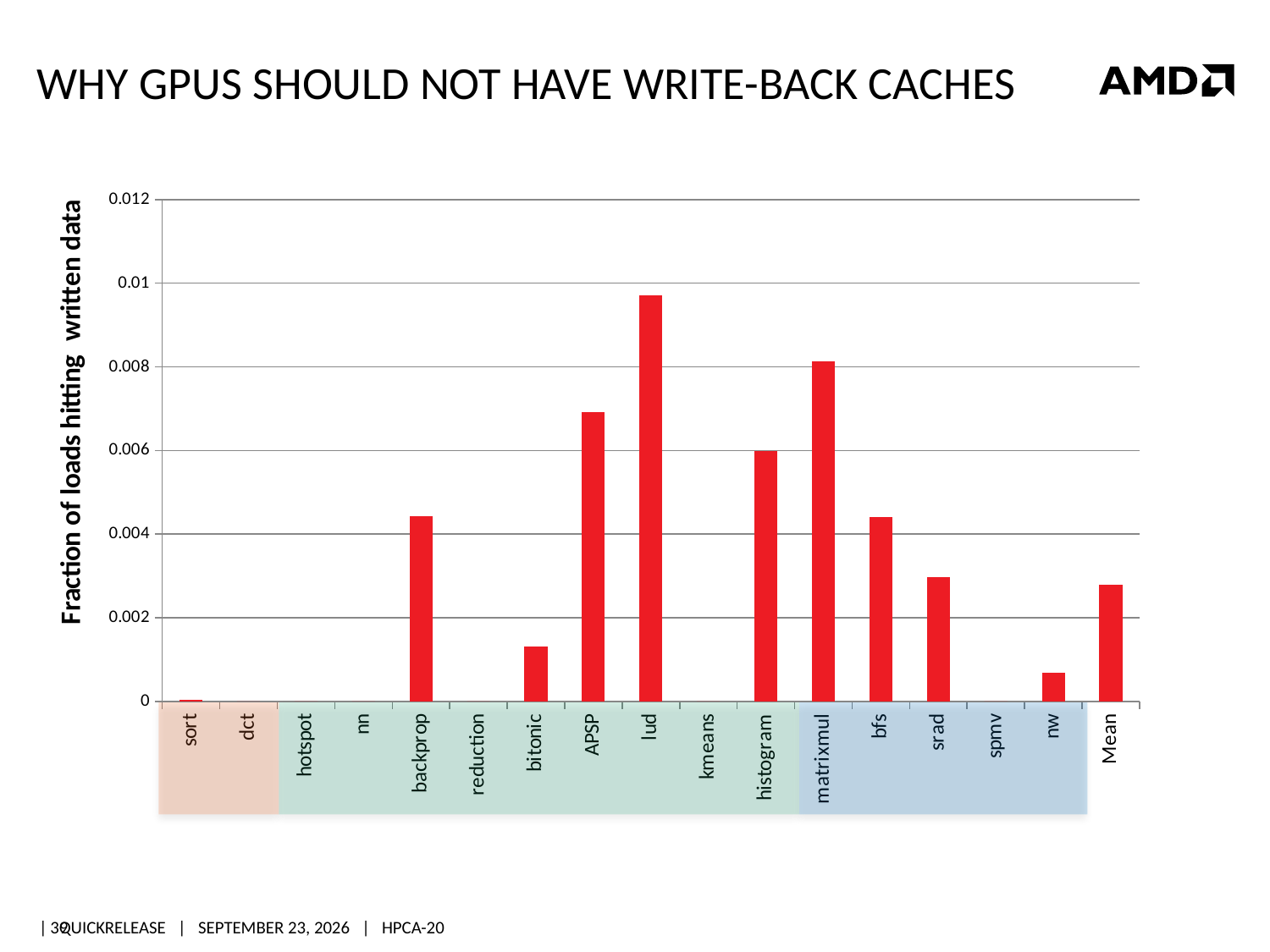
What is the label on the vertical axis of the chart? Fraction of loads hitting written data What kind of chart is shown on the slide? bar chart Is the value for matrixmul greater or less than 0.01? less Which is larger, the value for APSP or the value for histogram? APSP Is the value for nw greater or less than 0.002? less Which category has the highest fraction of loads hitting written data? lud Is the value for lud greater or less than 0.008? greater How many categories are shown along the x axis of the chart? 17 Which is larger, the value for lud or the value for matrixmul? lud